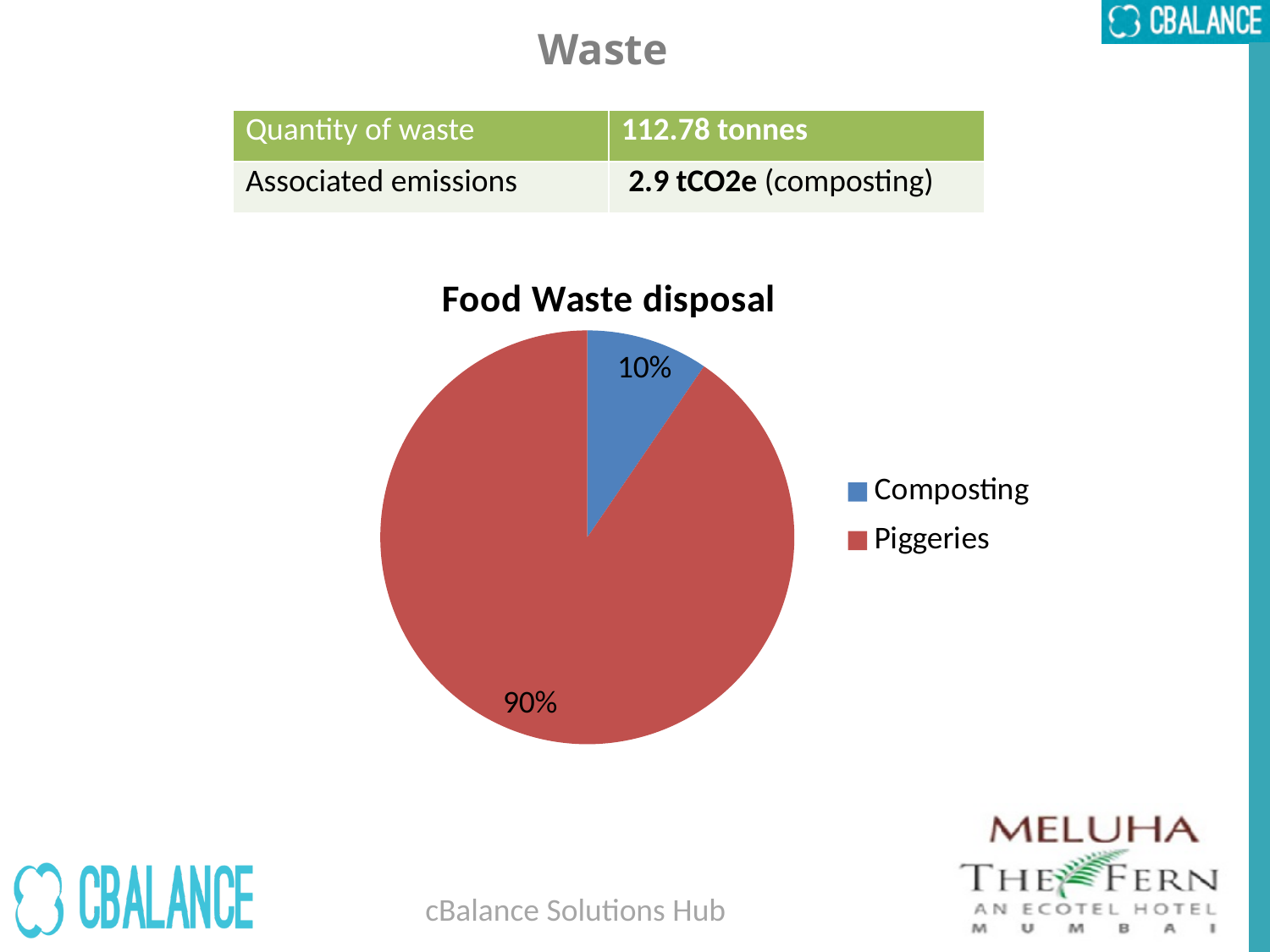
What colour is the Composting slice? blue Which disposal method has the smallest share of the pie? Composting Which is larger, the share for Composting or the share for Piggeries? Piggeries What share of food waste disposal goes to Piggeries? 90% What type of chart is shown on the slide? pie chart How many entries does the legend list? 2 What is the difference in percentage points between the Piggeries share and the Composting share? 80% What share of food waste disposal goes to Composting? 10% What is the title of the chart? Food Waste disposal How many slices does the pie chart have? 2 Which disposal method has the largest share of the pie? Piggeries